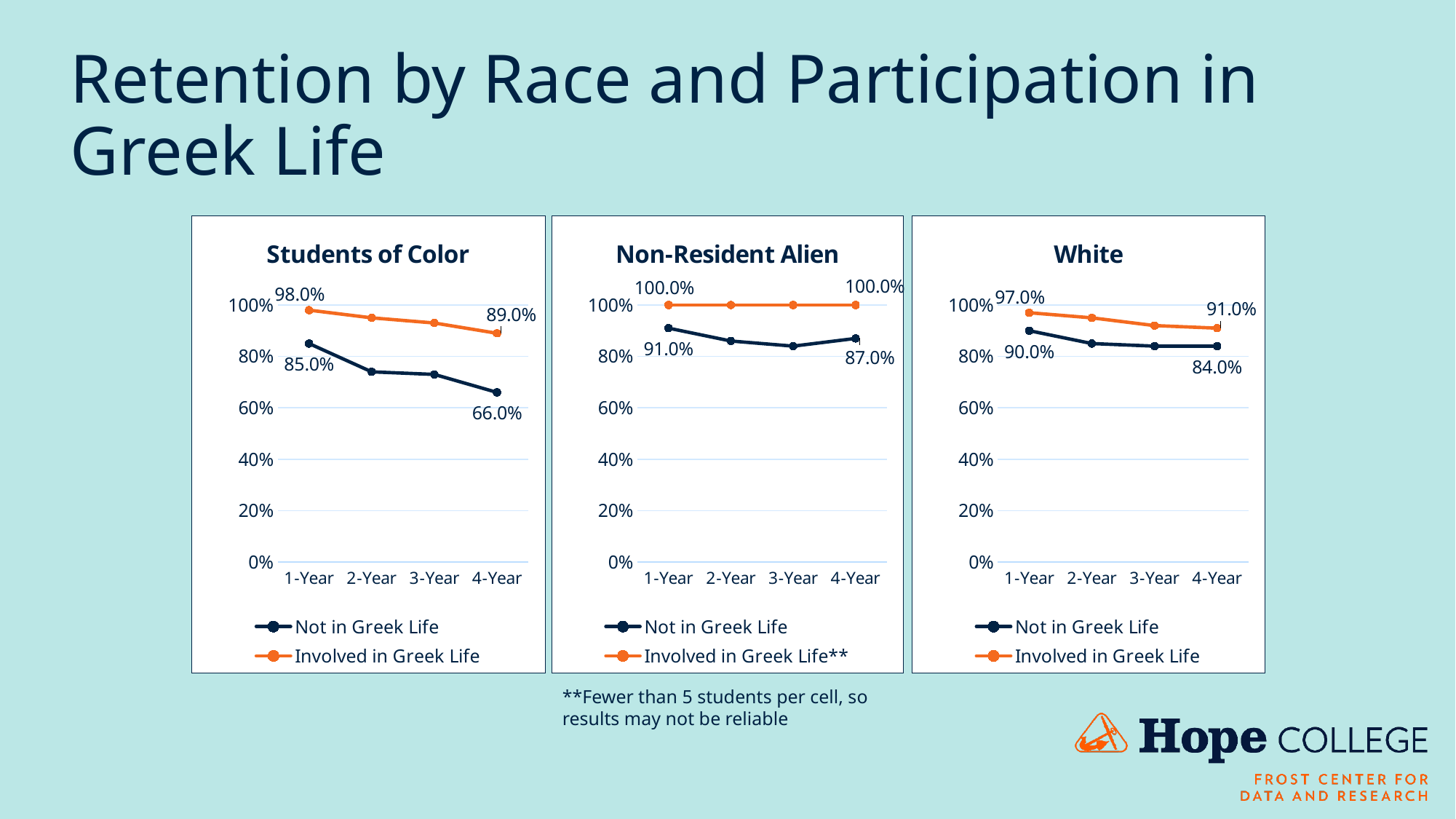
In the Students of Color chart, is the 2-Year value for Not in Greek Life greater or less than 80%? less How many series does the legend of the Non-Resident Alien chart list? 2 In the White chart, does the Not in Greek Life series rise or fall from 1-Year to 4-Year? fall In the Non-Resident Alien chart, what is the 4-Year retention value for Not in Greek Life? 87.0% In the Students of Color chart, what is the 4-Year retention value for Not in Greek Life? 66.0% What kind of chart is the White chart? line chart In the Students of Color chart, what is the 1-Year retention value for Involved in Greek Life? 98.0% In the White chart, what is the difference between the 1-Year and 4-Year values for Not in Greek Life? 6.0% In the Non-Resident Alien chart, what is the 1-Year retention value for Involved in Greek Life**? 100.0% In the White chart, what is the 4-Year retention value for Involved in Greek Life? 91.0% In the Students of Color chart, what is the difference between the 1-Year and 4-Year values for Not in Greek Life? 19.0% In the Students of Color chart, which series has the higher 4-Year value, Not in Greek Life or Involved in Greek Life? Involved in Greek Life